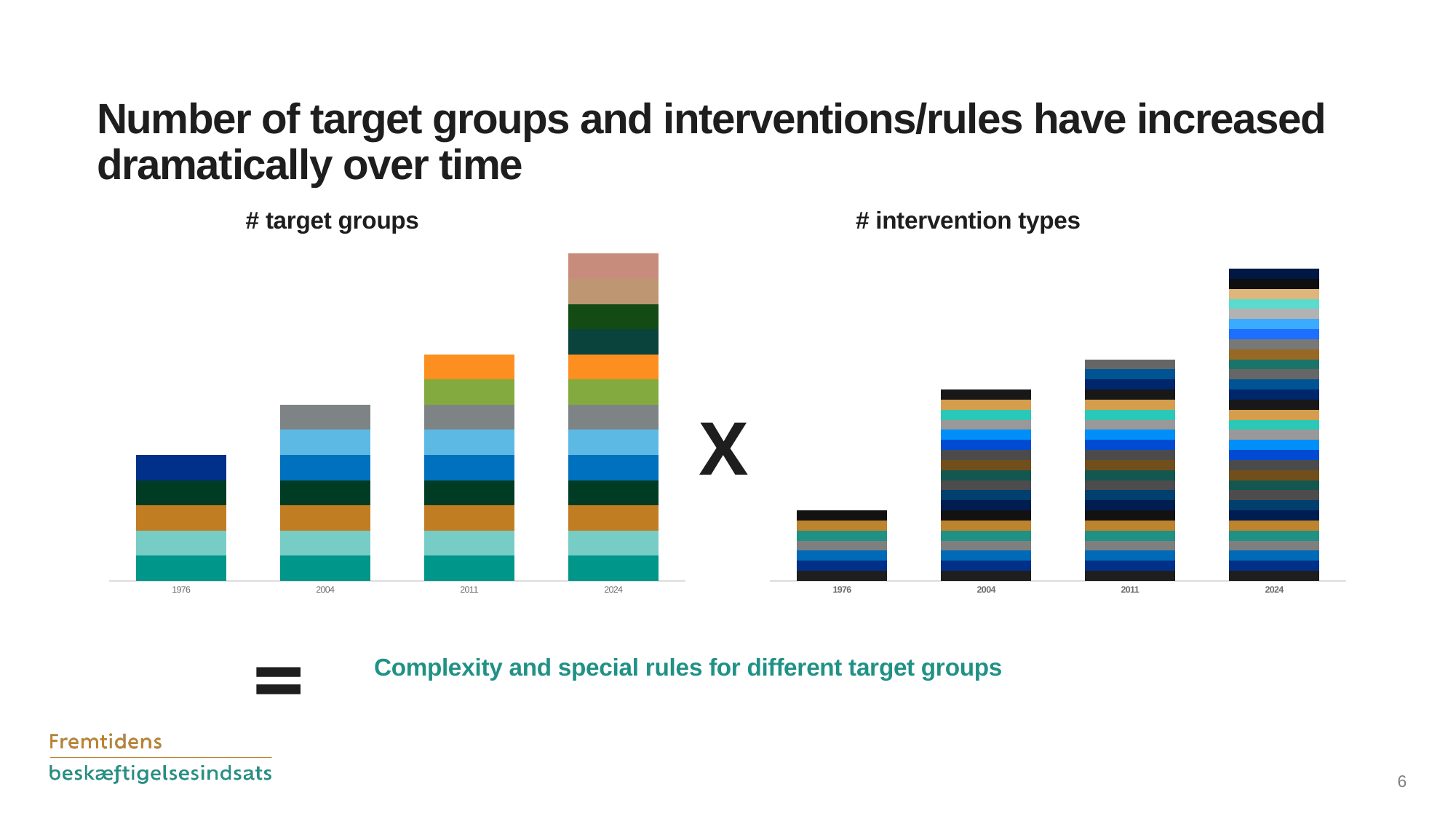
In the '# target groups' chart, is the bar for 2004 taller or shorter than the bar for 2011? Shorter In the '# target groups' chart, which year has the tallest bar? 2024 What kind of chart is the '# intervention types' chart on the right? Stacked bar chart In the '# intervention types' chart, which year has the tallest bar? 2024 In the '# intervention types' chart, which year has the shortest bar? 1976 In the '# intervention types' chart, is the bar for 2011 taller or shorter than the bar for 2004? Taller In the '# target groups' chart, do the bar heights rise or fall from 1976 to 2024? Rise In the '# target groups' chart, which year has the shortest bar? 1976 In the '# target groups' chart, how many years are shown on the x axis? 4 In the '# intervention types' chart, how many bars are there? 4 What is the title of the chart on the right side of the slide? # intervention types What kind of chart is the '# target groups' chart on the left? Stacked bar chart